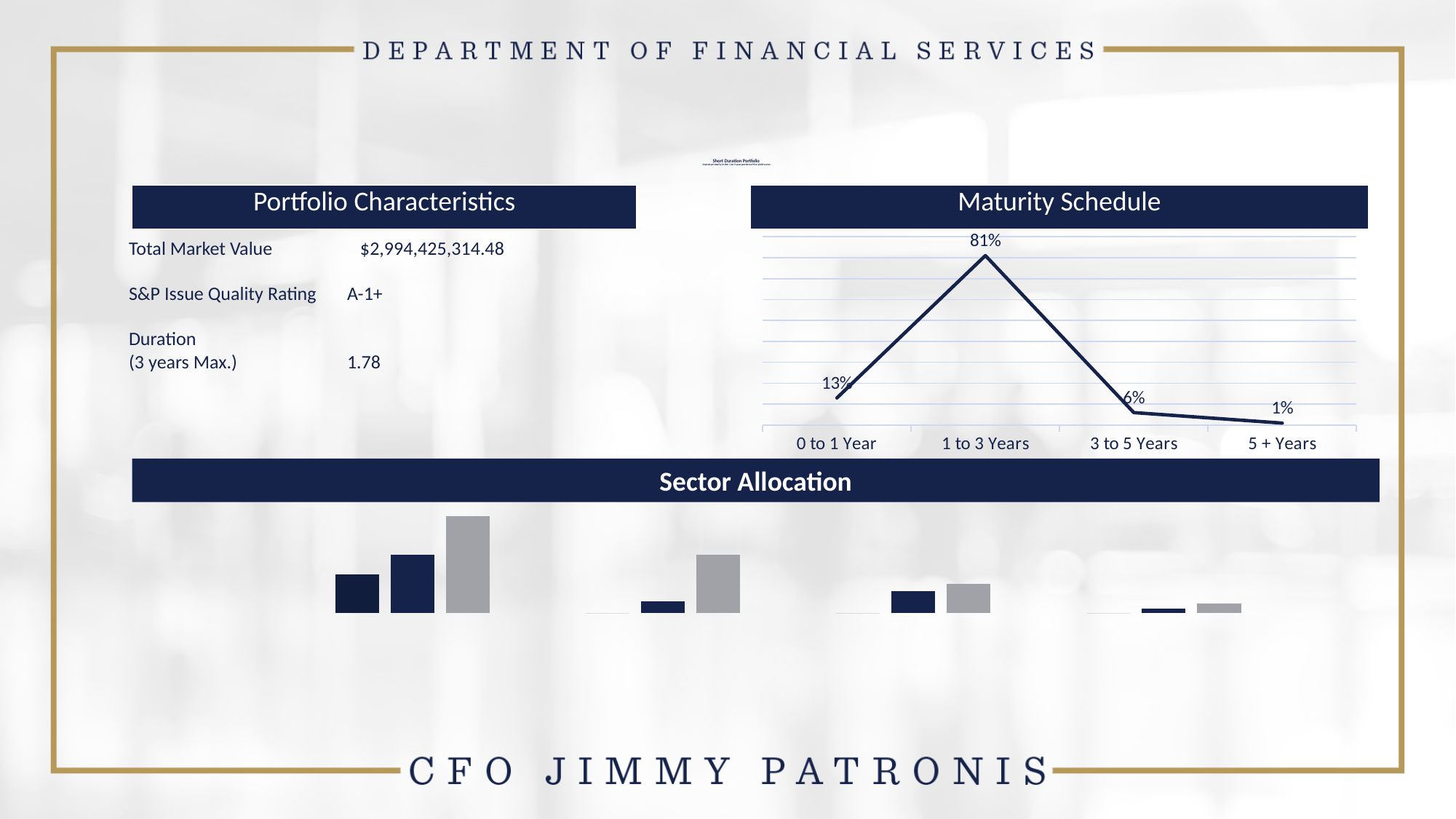
What kind of chart is the Maturity Schedule chart? Line chart In the Maturity Schedule chart, what is the value for 3 to 5 Years? 6% In the Maturity Schedule chart, what is the difference between the values for 3 to 5 Years and 5 + Years? 5% In the Maturity Schedule chart, which is larger: the value for 0 to 1 Year or the value for 3 to 5 Years? 0 to 1 Year In the Maturity Schedule chart, which maturity bucket has the highest value? 1 to 3 Years In the Maturity Schedule chart, which maturity bucket has the lowest value? 5 + Years In the Maturity Schedule chart, what is the value for 1 to 3 Years? 81% How many maturity buckets are plotted in the Maturity Schedule chart? 4 In the Maturity Schedule chart, what is the value for 0 to 1 Year? 13% In the Maturity Schedule chart, what is the difference between the values for 1 to 3 Years and 0 to 1 Year? 68% In the Maturity Schedule chart, what is the value for 5 + Years? 1% What kind of chart is the Sector Allocation chart? Bar chart